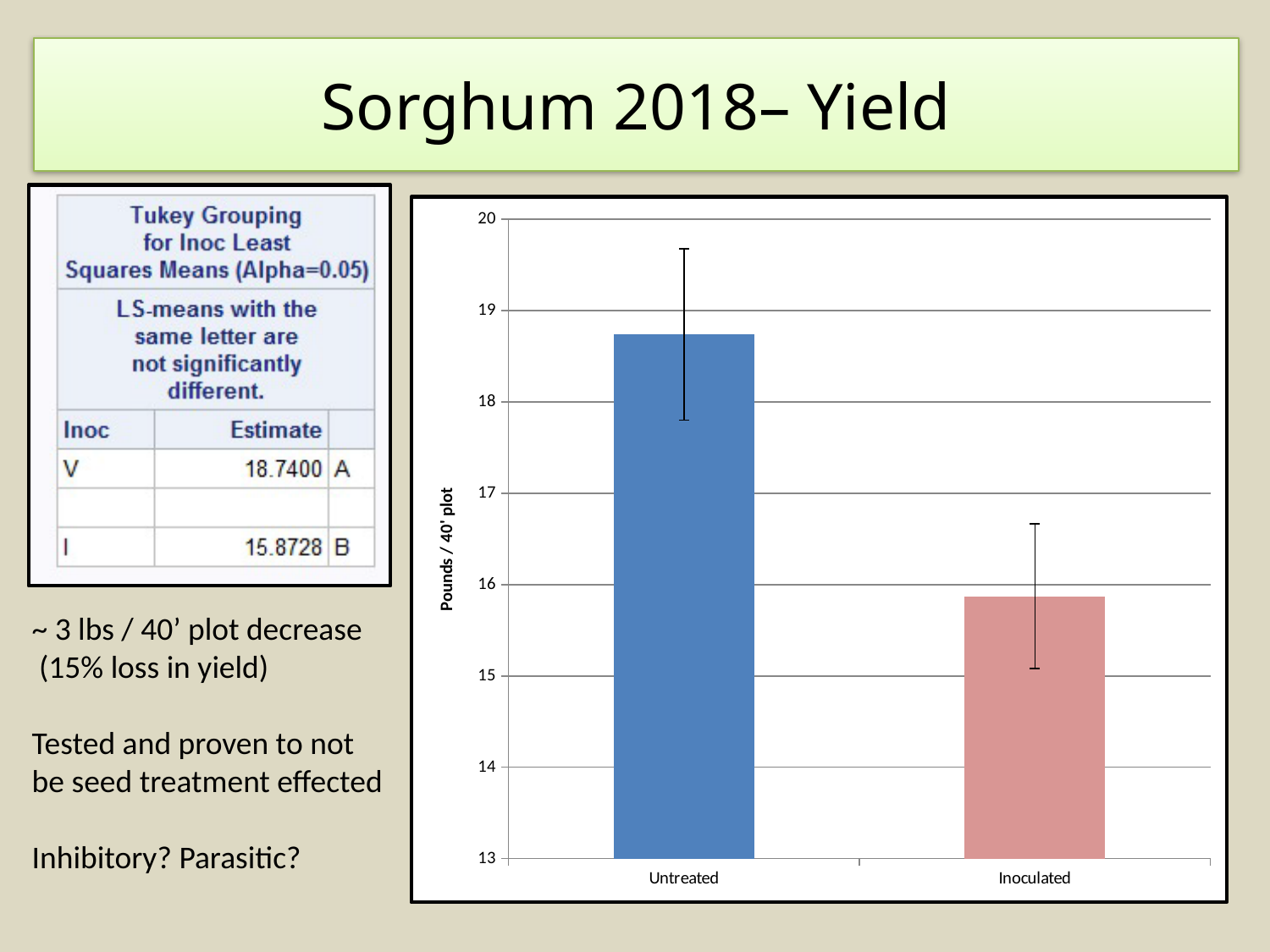
Is the value for Inoculated greater or less than 16? less What is the lowest value shown on the chart's y axis? 13 Is the value for Inoculated greater or less than 15? greater Is the value for Untreated greater or less than 18? greater What kind of chart is shown on the slide? bar chart Do the bar values rise or fall moving from Untreated to Inoculated along the x axis? fall How many categories are plotted on the x axis of the chart? 2 Which category has the highest bar in the chart? Untreated What is the label of the chart's y axis? Pounds / 40' plot Which bar is taller, Untreated or Inoculated? Untreated Which category has the lowest bar in the chart? Inoculated